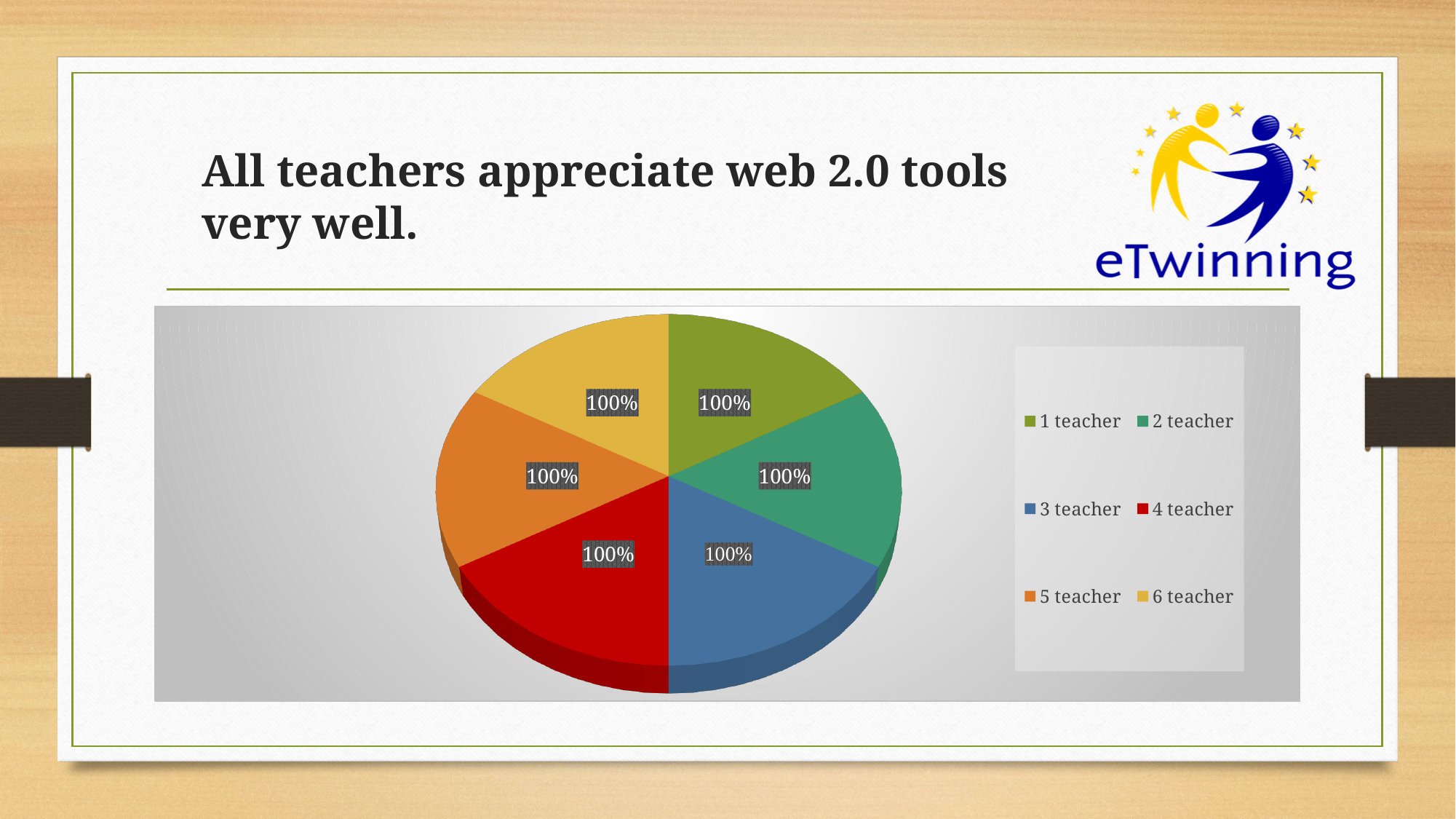
Which legend entry is shown in red? 4 teacher How many slices does the pie chart have? 6 What data label is shown on the slice for 4 teacher? 100% What data label is shown on the slice for 3 teacher? 100% What colour is the slice for 6 teacher? yellow What data label is shown on the slice for 1 teacher? 100% What data label is shown on the slice for 6 teacher? 100% How many entries does the legend of the pie chart list? 6 What kind of chart is shown on the slide? pie chart